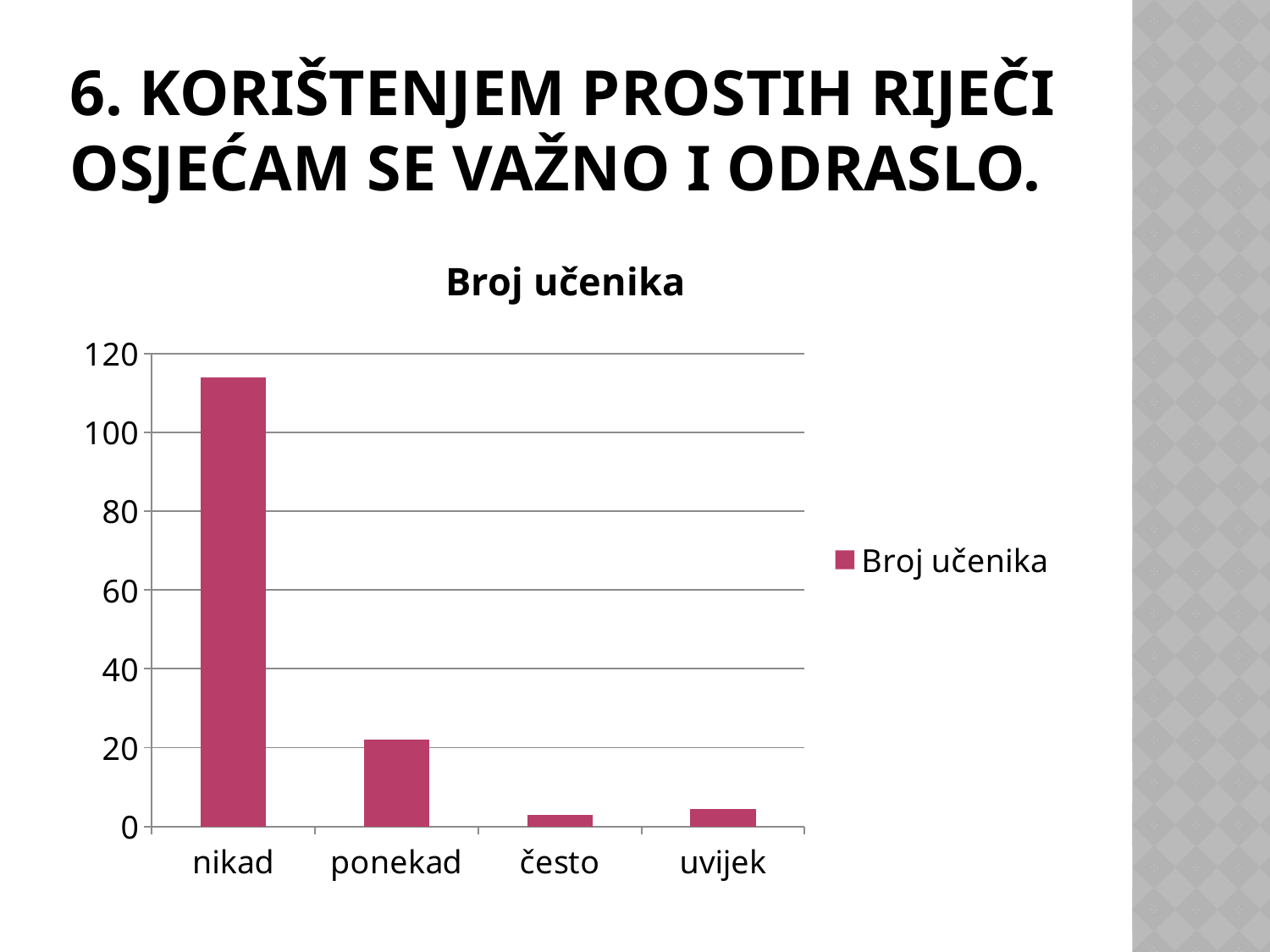
Is the value for uvijek greater or less than 20? less Which is larger, the value for ponekad or the value for uvijek? ponekad How many series does the legend list? 1 How many categories are shown on the x axis of the chart? 4 Is the value for ponekad greater or less than 40? less Which is larger, the value for nikad or the value for ponekad? nikad What is the name of the series shown in the legend? Broj učenika Is the value for nikad greater or less than 100? greater Which category has the lowest value? često What type of chart is shown on the slide? bar chart What is the title of the chart? Broj učenika Which category has the highest value? nikad